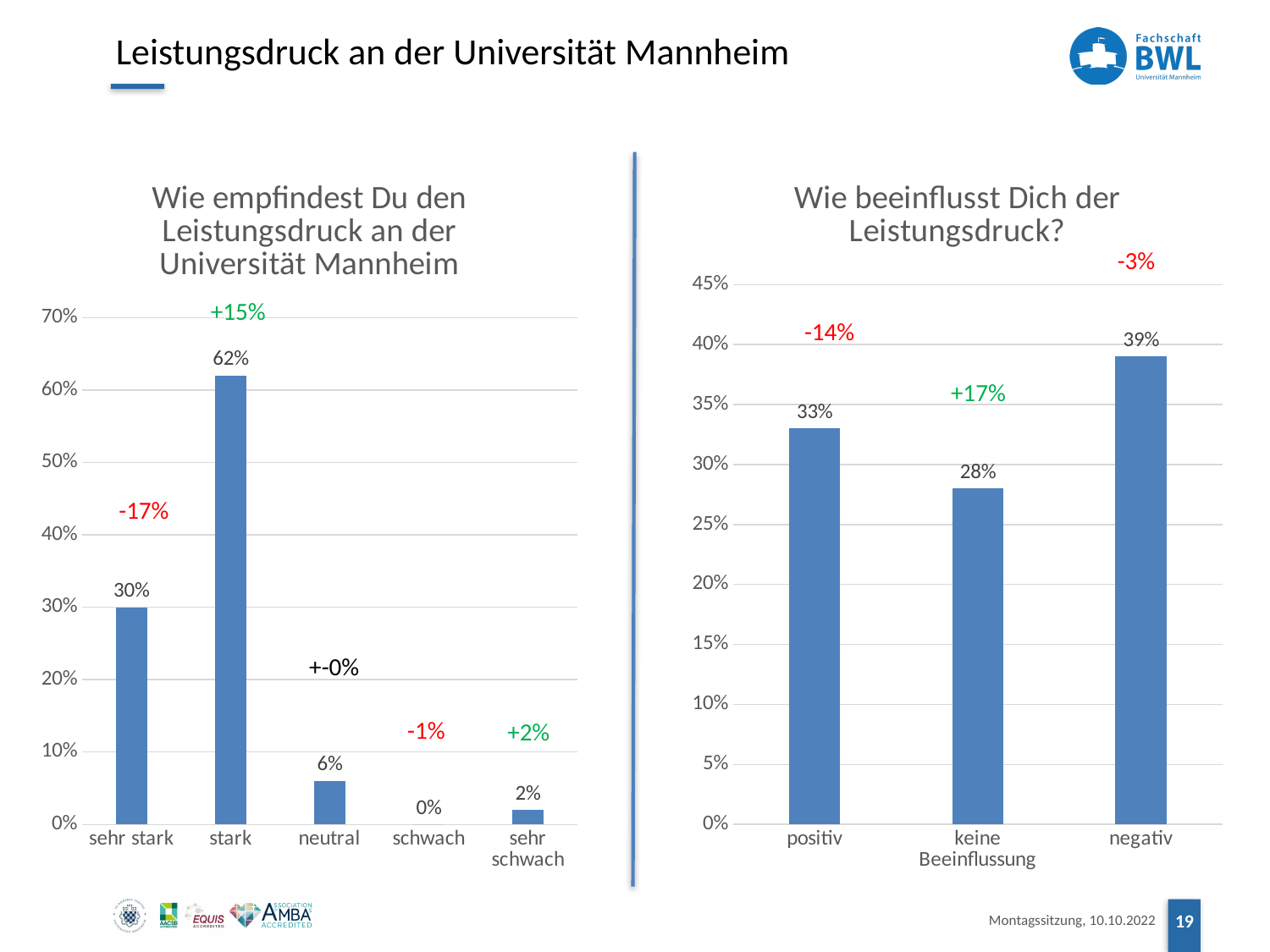
In the chart titled "Wie empfindest Du den Leistungsdruck an der Universität Mannheim", what is the value for "sehr stark"? 30% In the chart titled "Wie beeinflusst Dich der Leistungsdruck?", which is larger, the value for "positiv" or the value for "negativ"? negativ What kind of chart is the chart titled "Wie beeinflusst Dich der Leistungsdruck?"? bar chart In the chart titled "Wie empfindest Du den Leistungsdruck an der Universität Mannheim", how many categories are shown on the x axis? 5 In the chart titled "Wie beeinflusst Dich der Leistungsdruck?", what is the difference between the values for "negativ" and "positiv"? 6% In the chart titled "Wie empfindest Du den Leistungsdruck an der Universität Mannheim", which category has the lowest value? schwach In the chart titled "Wie beeinflusst Dich der Leistungsdruck?", which category has the lowest value? keine Beeinflussung In the chart titled "Wie empfindest Du den Leistungsdruck an der Universität Mannheim", what is the difference between the values for "stark" and "sehr stark"? 32% In the chart titled "Wie beeinflusst Dich der Leistungsdruck?", what is the value for "negativ"? 39% In the chart titled "Wie beeinflusst Dich der Leistungsdruck?", what is the value for "keine Beeinflussung"? 28% In the chart titled "Wie empfindest Du den Leistungsdruck an der Universität Mannheim", what is the value for "stark"? 62% In the chart titled "Wie empfindest Du den Leistungsdruck an der Universität Mannheim", which category has the highest value? stark